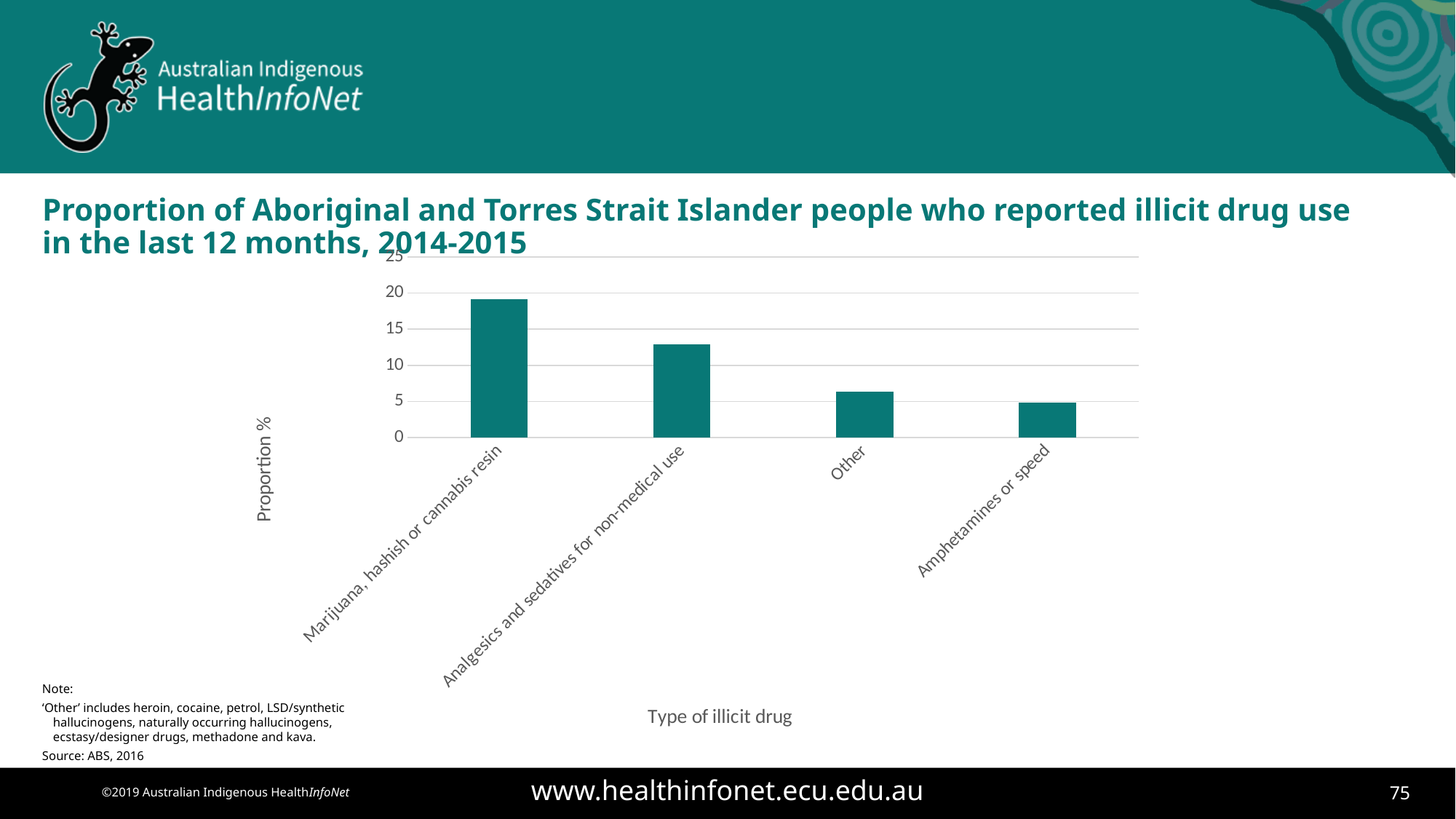
Which is larger, the value for Other or the value for Amphetamines or speed? Other Do the values rise or fall moving from left to right along the x axis? fall Which type of illicit drug has the highest reported proportion? Marijuana, hashish or cannabis resin Is the value for Analgesics and sedatives for non-medical use greater or less than 15? less How many types of illicit drug are plotted in the chart? 4 Which type of illicit drug has the lowest reported proportion? Amphetamines or speed Is the value for Other greater or less than 10? less Is the value for Analgesics and sedatives for non-medical use greater or less than 10? greater What kind of chart is shown on the slide? bar chart What is the title of the vertical axis? Proportion %